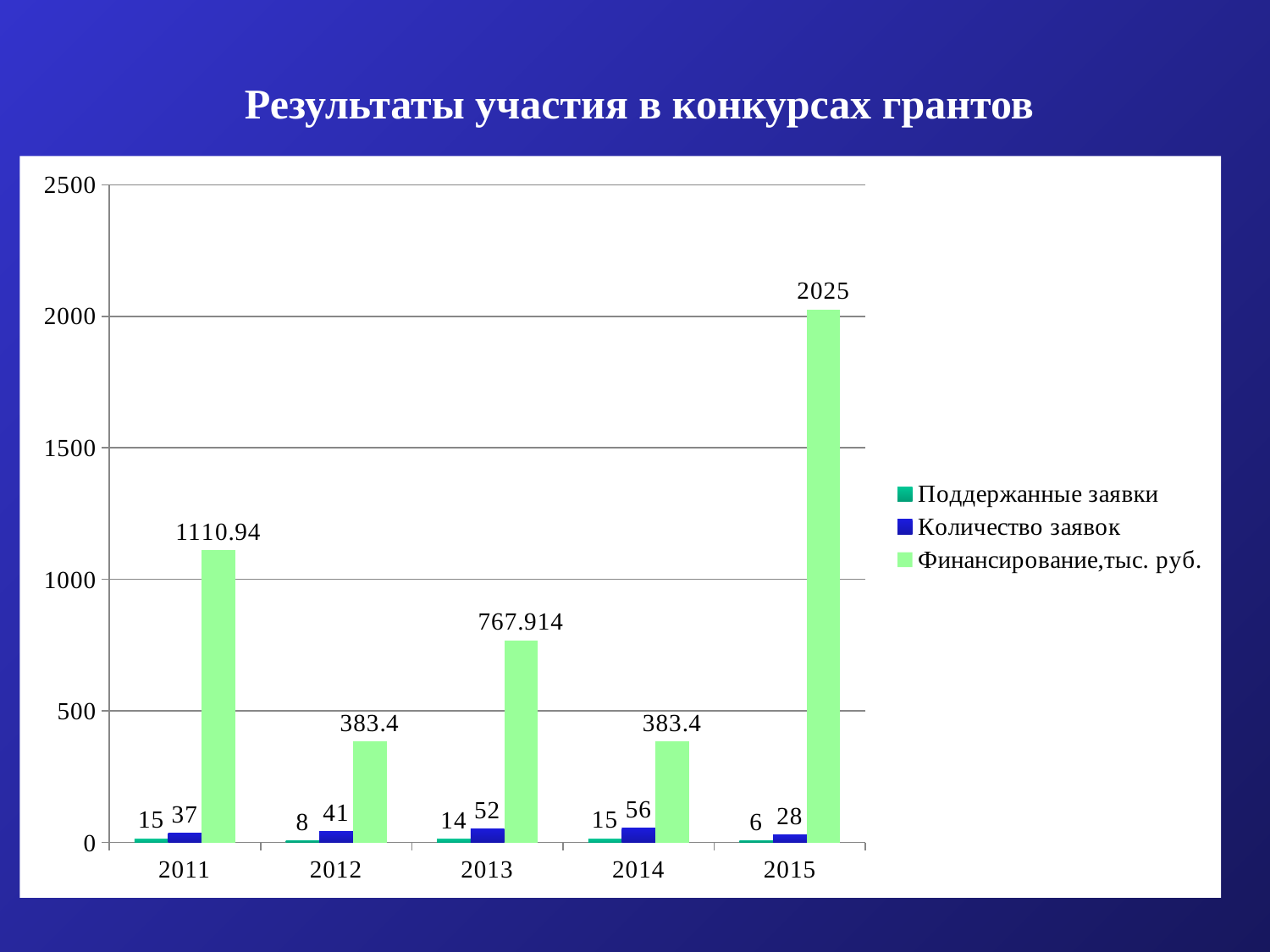
Is the value of Финансирование,тыс. руб. for 2011 greater or less than 1000? greater What is the value of Поддержанные заявки for 2012? 8 Which is larger: Финансирование,тыс. руб. in 2013 or in 2012? 2013 Which year has the highest value of Финансирование,тыс. руб.? 2015 What is the value of Количество заявок for 2013? 52 What is the difference between Количество заявок in 2014 and in 2011? 19 What is the value of Финансирование,тыс. руб. for 2011? 1110.94 What kind of chart is shown on the slide? bar chart How many series does the legend list? 3 Which year has the lowest value of Количество заявок? 2015 What is the value of Финансирование,тыс. руб. for 2015? 2025 How many years are shown on the x axis? 5